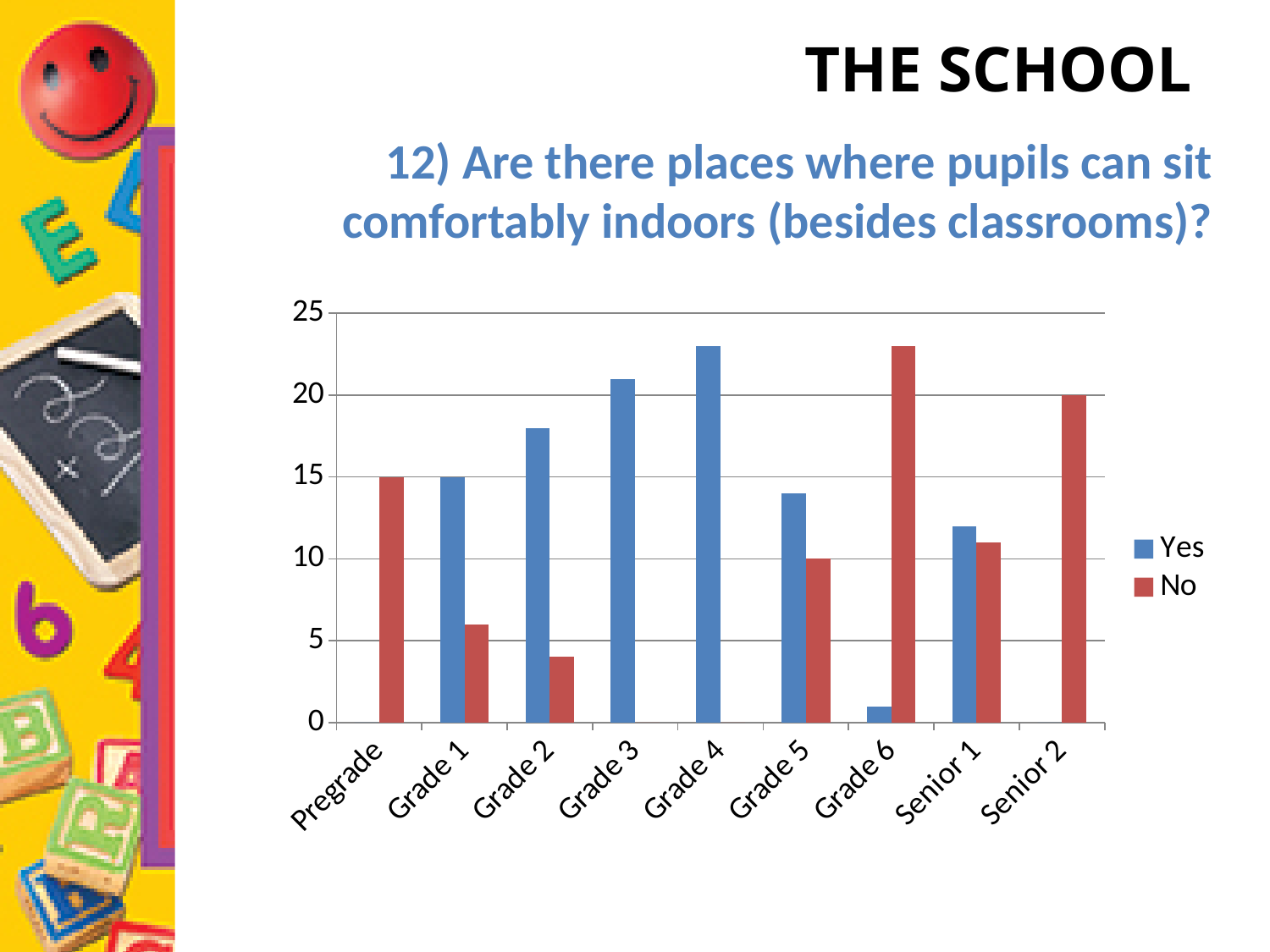
For Grade 2, which is larger, the 'Yes' value or the 'No' value? Yes What kind of chart is shown on the slide? bar chart What is the 'Yes' value for Grade 1? 15 Which grade has the highest 'No' value? Grade 6 Is the 'Yes' value for Grade 3 greater or less than 20? greater How many grade categories are shown on the x axis? 9 How many series does the legend list? 2 What is the 'No' value for Senior 2? 20 Is the 'No' value for Grade 2 greater or less than 5? less What is the 'No' value for Grade 5? 10 What is the 'No' value for Pregrade? 15